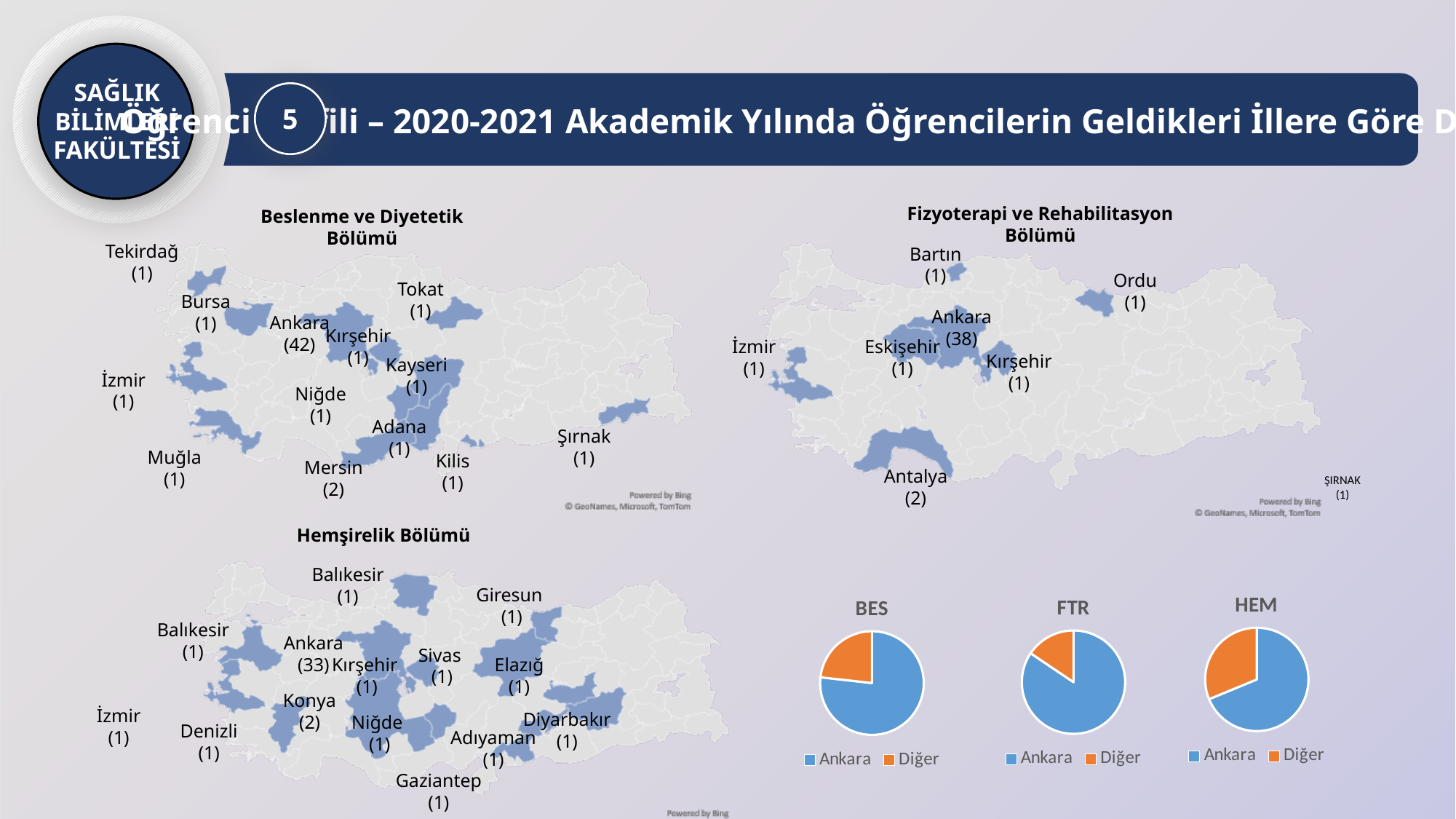
On the Fizyoterapi ve Rehabilitasyon Bölümü map, how many students came from Antalya? 2 On the Hemşirelik Bölümü map, how many students came from Ankara? 33 What kind of chart are the BES, FTR and HEM charts at the bottom right of the slide? Pie chart On the Beslenme ve Diyetetik Bölümü map, how many students came from Mersin? 2 On the Hemşirelik Bölümü map, how many students came from Konya? 2 In the BES pie chart, which slice is larger, Ankara or Diğer? Ankara On the Beslenme ve Diyetetik Bölümü map, what is the difference between the number of students from Ankara and from Mersin? 40 On the Beslenme ve Diyetetik Bölümü map, which province has the highest number of students? Ankara On the Beslenme ve Diyetetik Bölümü map, how many students came from Ankara? 42 Which department map shows more students from Ankara, Beslenme ve Diyetetik Bölümü or Hemşirelik Bölümü? Beslenme ve Diyetetik Bölümü On the Fizyoterapi ve Rehabilitasyon Bölümü map, how many students came from Ankara? 38 How many entries does the legend of the FTR pie chart list? 2